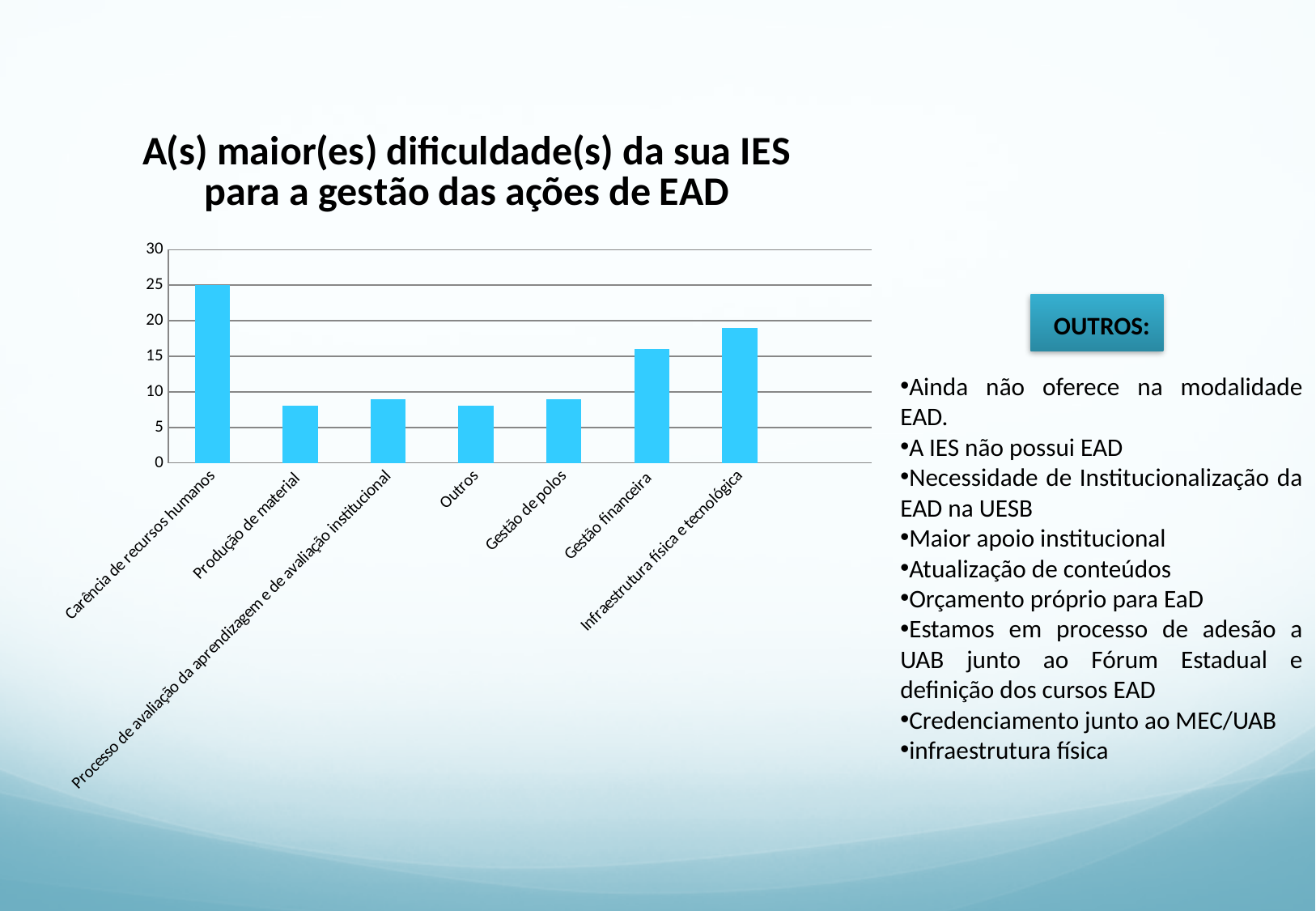
Which is larger, the value for Gestão financeira or the value for Infraestrutura física e tecnológica? Infraestrutura física e tecnológica What kind of chart is shown on the slide? bar chart Is the value for Infraestrutura física e tecnológica greater or less than 15? greater What is the value for Carência de recursos humanos? 25 What is the title of the chart? A(s) maior(es) dificuldade(s) da sua IES para a gestão das ações de EAD Is the value for Outros greater or less than 10? less How many categories are shown on the x axis? 7 Is the value for Gestão financeira greater or less than 20? less Which is larger, the value for Carência de recursos humanos or the value for Gestão financeira? Carência de recursos humanos Which category has the highest value? Carência de recursos humanos